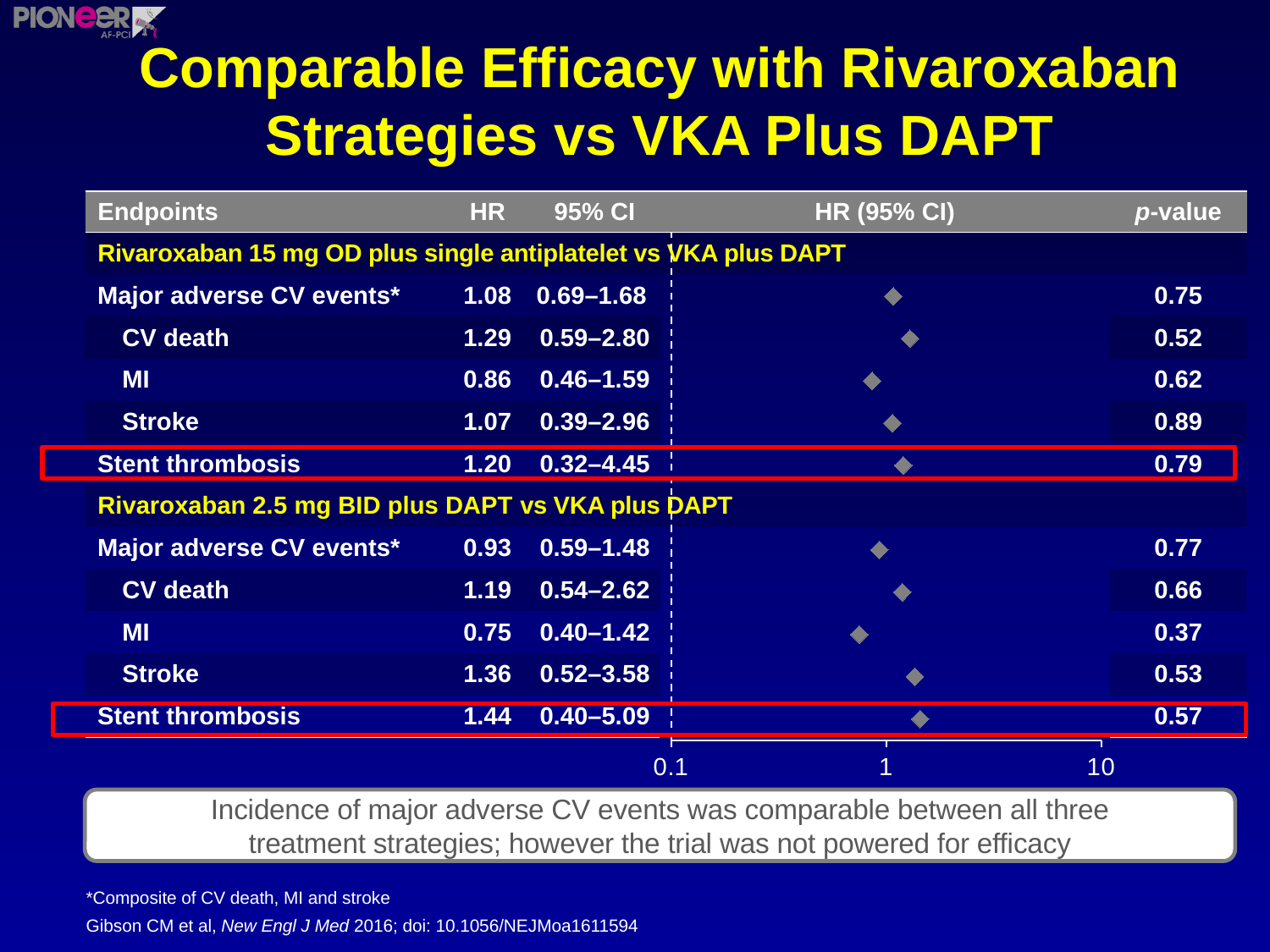
What is the HR for Stent thrombosis in the Rivaroxaban 15 mg OD plus single antiplatelet vs VKA plus DAPT comparison? 1.20 What HR value does the dashed vertical line in the forest plot mark? 0.1 What are the tick values shown on the x axis of the forest plot? 0.1, 1, 10 How many endpoints are plotted for each of the two treatment comparisons? 5 What is the difference between the HR for Stent thrombosis in the 2.5 mg BID comparison and the HR for Stent thrombosis in the 15 mg OD comparison? 0.24 What is the 95% CI for Stroke in the Rivaroxaban 2.5 mg BID plus DAPT vs VKA plus DAPT comparison? 0.52–3.58 Which has the larger HR for CV death: the Rivaroxaban 15 mg OD comparison or the Rivaroxaban 2.5 mg BID comparison? Rivaroxaban 15 mg OD comparison (1.29) What is the p-value for MI in the Rivaroxaban 2.5 mg BID plus DAPT vs VKA plus DAPT comparison? 0.37 Which endpoint has the highest HR across both comparisons on the slide? Stent thrombosis (Rivaroxaban 2.5 mg BID plus DAPT vs VKA plus DAPT), 1.44 What kind of chart is shown in the HR (95% CI) column of the slide? forest plot Which endpoint has the lowest HR across both comparisons on the slide? MI (Rivaroxaban 2.5 mg BID plus DAPT vs VKA plus DAPT), 0.75 Is the HR for MI in the Rivaroxaban 15 mg OD plus single antiplatelet vs VKA plus DAPT comparison greater or less than 1? less